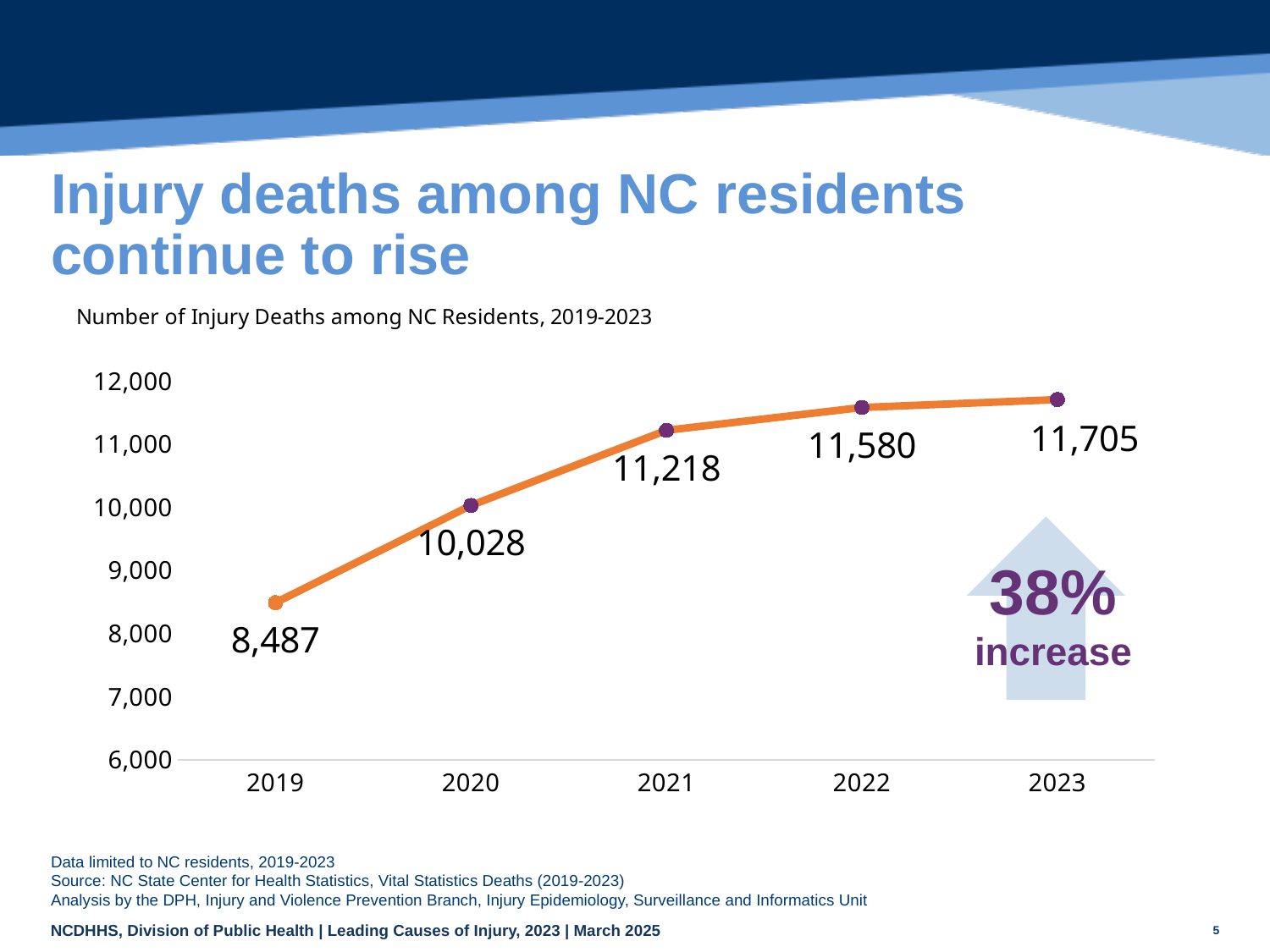
What kind of chart is shown on the slide? line chart What is the number of injury deaths among NC residents in 2023? 11,705 Do injury deaths rise or fall from 2019 to 2023? rise Which year has the highest number of injury deaths? 2023 How many years are plotted on the chart? 5 What is the number of injury deaths among NC residents in 2019? 8,487 Is the value for 2020 greater or less than 9,000? greater What is the difference in injury deaths between 2023 and 2019? 3,218 What is the difference in injury deaths between 2021 and 2020? 1,190 Which year has the lowest number of injury deaths? 2019 Which year had more injury deaths, 2020 or 2022? 2022 What is the number of injury deaths among NC residents in 2021? 11,218